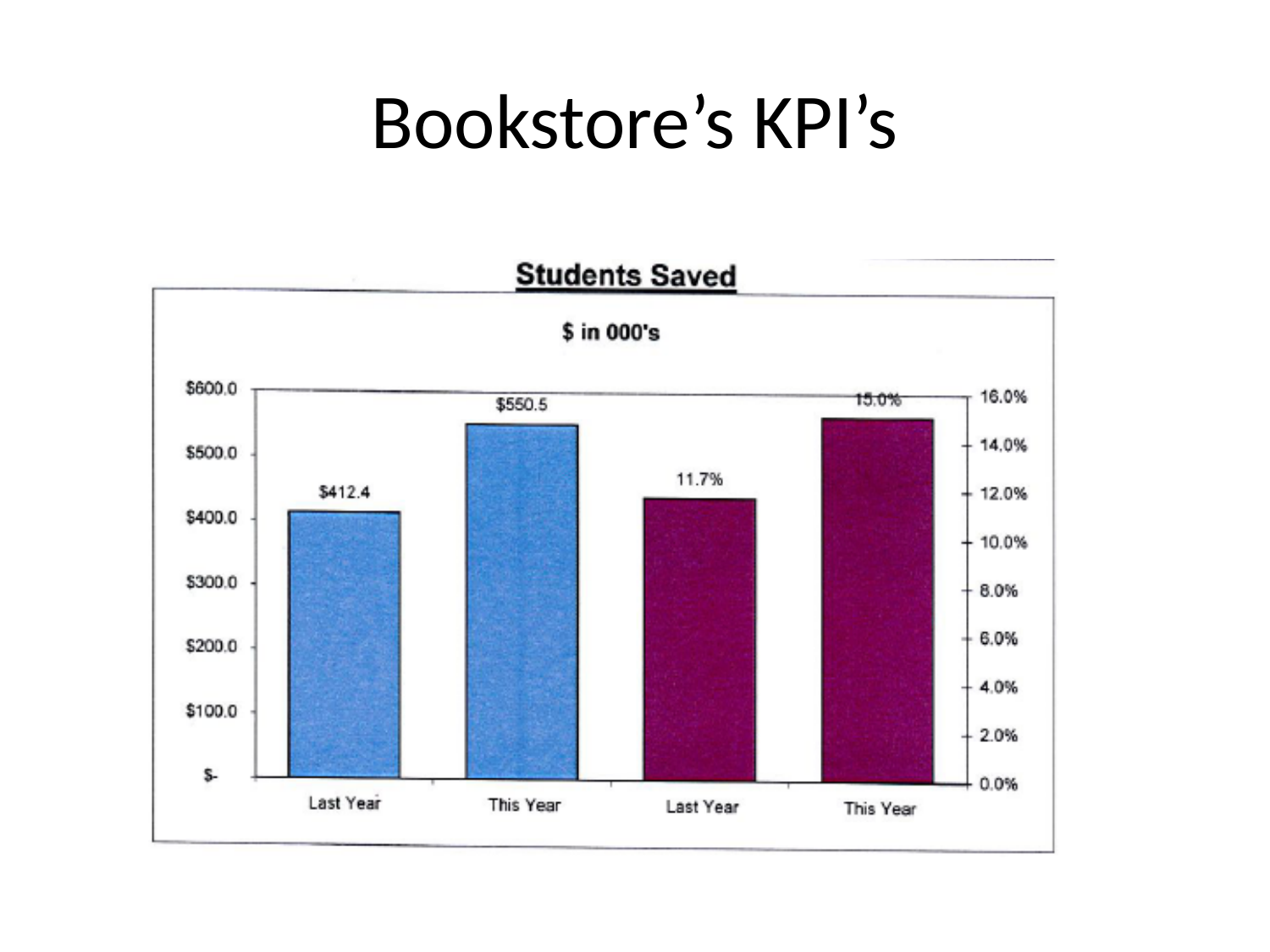
What is the difference between the This Year and Last Year percentage values? 3.3% What is the title of the chart? Students Saved How many bars are plotted in the chart? 4 What is the dollar value for This Year in the Students Saved chart? $550.5 What is the dollar value for Last Year in the Students Saved chart? $412.4 What is the percentage value for This Year in the Students Saved chart? 15.0% Is the Last Year dollar value greater or less than $500.0? less What kind of chart is shown on the slide? bar chart What is the difference between the This Year and Last Year dollar values? $138.1 What is the percentage value for Last Year in the Students Saved chart? 11.7% What unit is stated in the chart's subtitle? $ in 000's Which of the two dollar bars is larger, Last Year or This Year? This Year